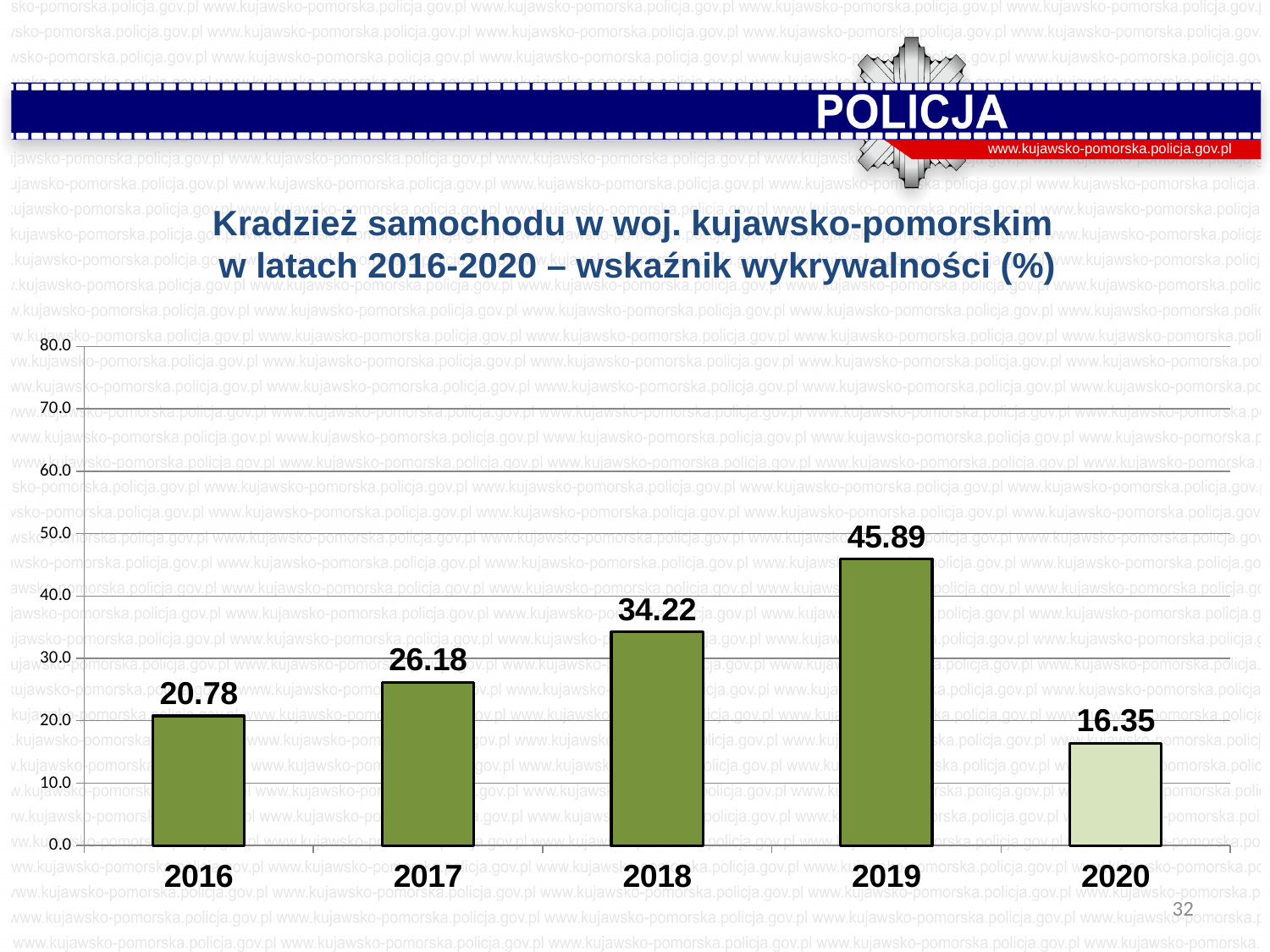
Do the values rise or fall from 2016 to 2019? rise Which is larger, the value for 2017 or the value for 2020? 2017 What is the difference between the values for 2019 and 2018? 11.67 What is the difference between the values for 2017 and 2016? 5.40 What is the value shown for 2020? 16.35 Is the value for 2018 greater or less than 30.0? greater Which year has the highest value? 2019 What is the value shown for 2016? 20.78 What kind of chart is shown on the slide? bar chart What is the detection rate value shown for 2019? 45.89 How many years are shown on the x axis? 5 Which year has the lowest value? 2020